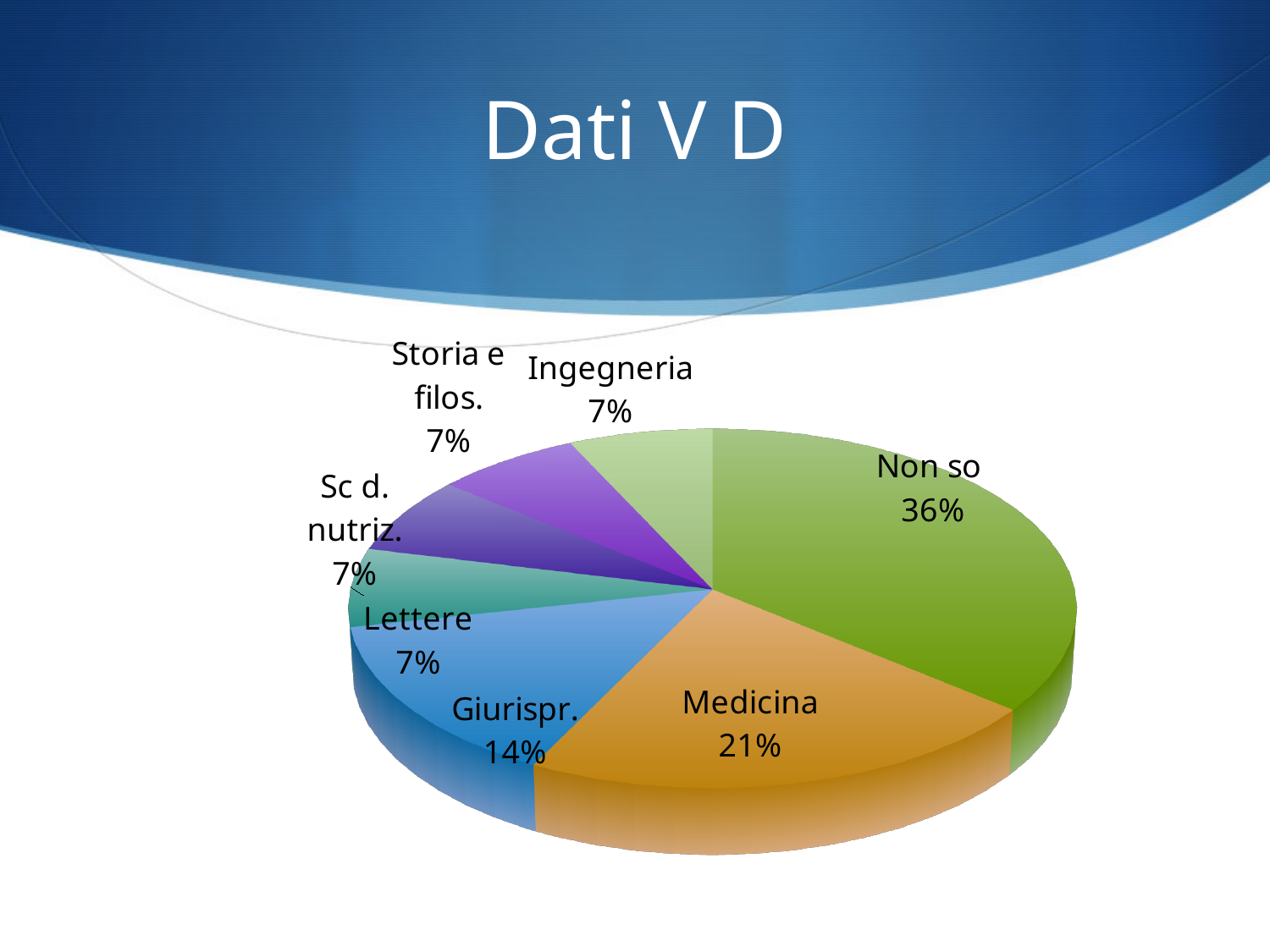
What share of the pie does Ingegneria have? 7% What is the title of the slide? Dati V D What is the difference between the Non so share and the Medicina share? 15% What kind of chart is shown on the slide? pie chart What share of the pie does Non so have? 36% Which category has the largest slice of the pie? Non so What colour is the Non so slice? green Which is larger, the Giurispr. slice or the Lettere slice? Giurispr. How many slices does the pie chart have? 7 What share of the pie does Medicina have? 21% What is the combined share of Medicina and Giurispr.? 35% What share of the pie does Giurispr. have? 14%